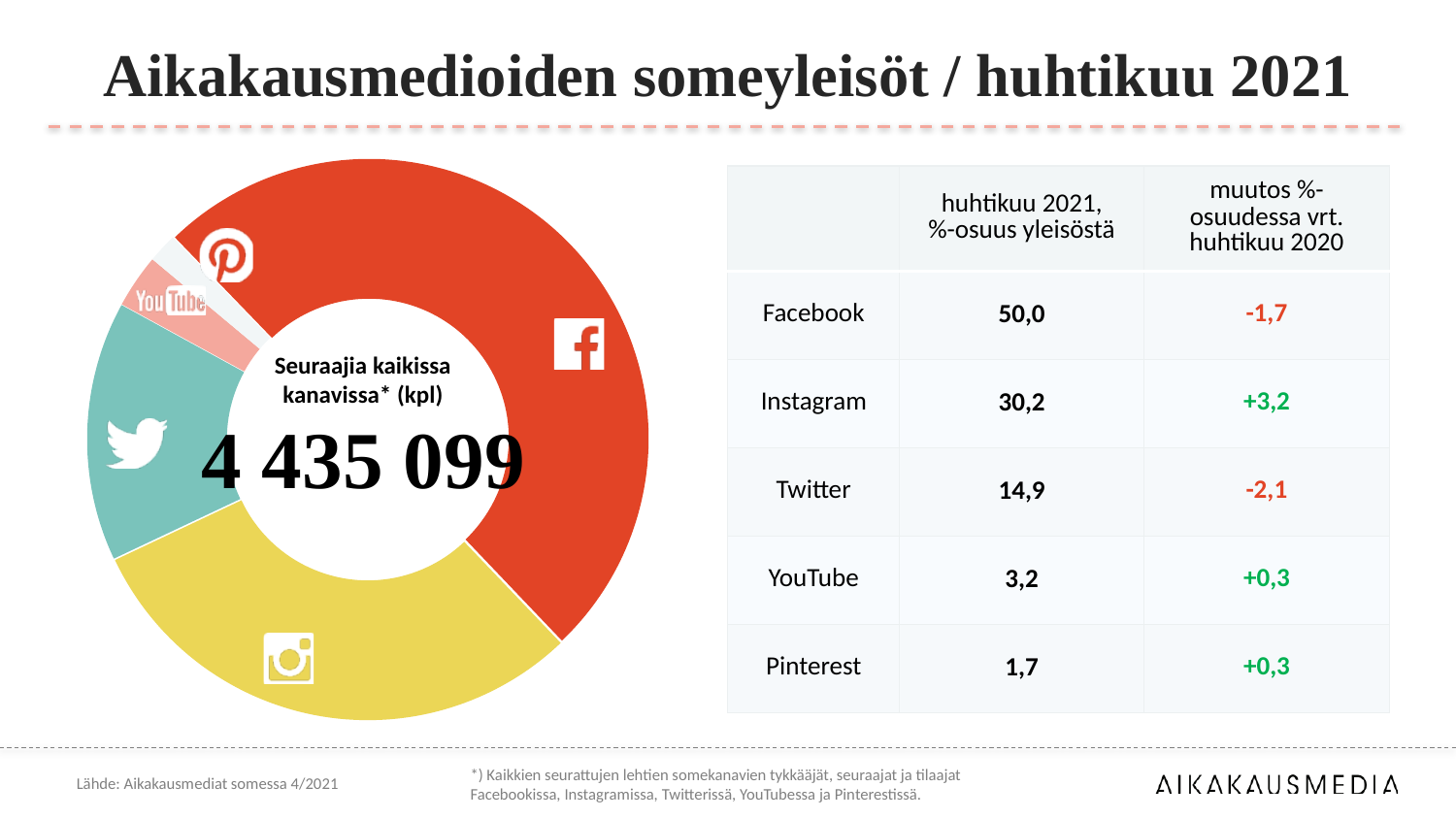
What kind of chart is shown on the left of the slide? Pie (donut) chart What colour is the Facebook slice of the donut chart? Red Which has the larger share of the audience, Twitter or YouTube? Twitter What is the difference between Facebook's and Instagram's shares of the audience? 19,8 What total number of followers is printed in the centre of the donut chart? 4 435 099 Which channel has the smallest slice of the donut chart? Pinterest What is the change in Twitter's share compared with April 2020? -2,1 How many social media channels (slices) does the donut chart show? 5 Which channel had the largest increase in share compared with April 2020? Instagram According to the table, what is Facebook's share of the audience in April 2021? 50,0 Which channel has the largest slice of the donut chart? Facebook According to the table, what is Instagram's share of the audience in April 2021? 30,2